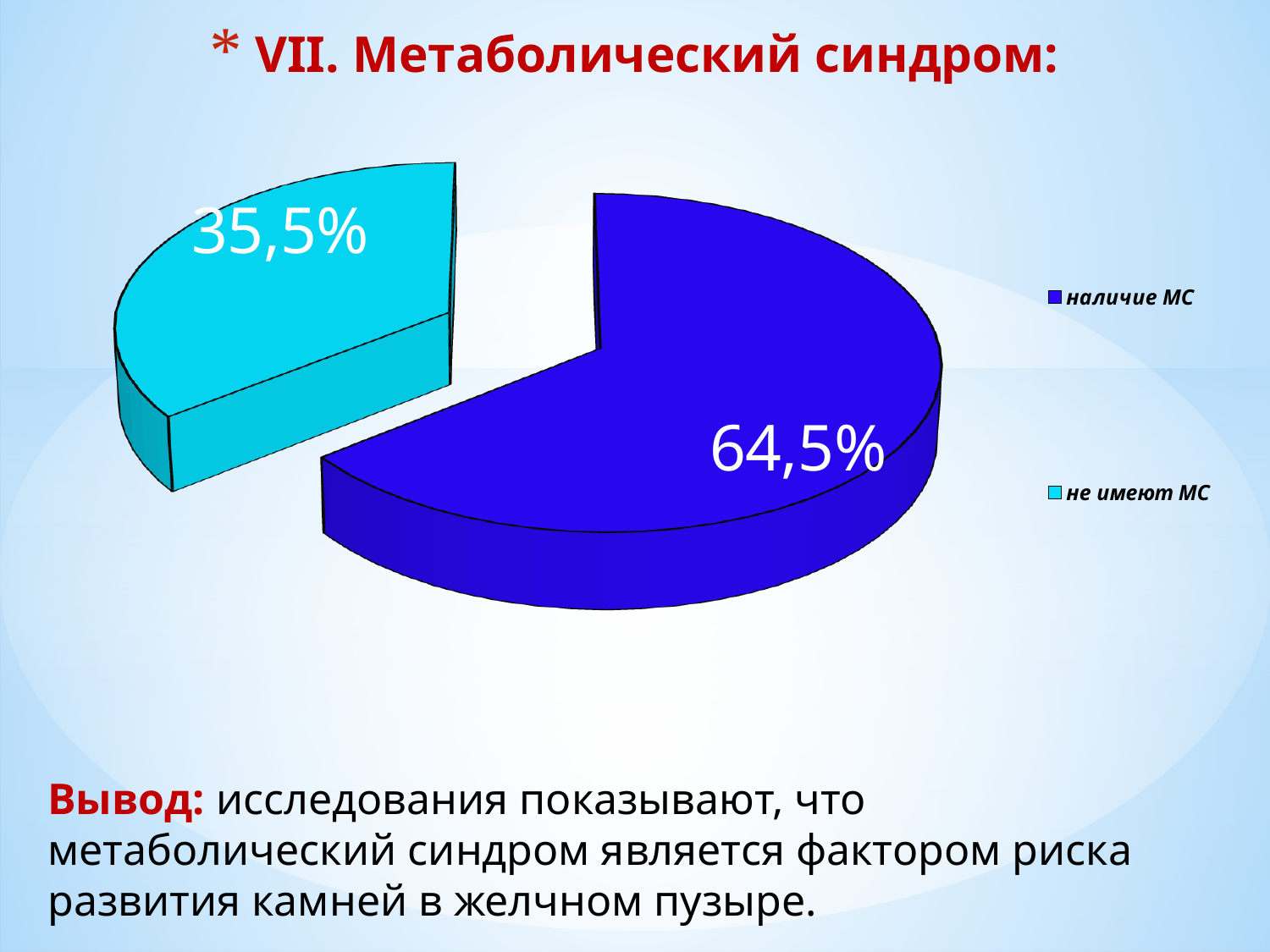
Which slice of the pie is the smallest? не имеют МС Which is larger: the share for "наличие МС" or for "не имеют МС"? наличие МС What share of the pie is labelled "не имеют МС"? 35,5% Which slice of the pie is the largest? наличие МС What colour is the "не имеют МС" slice? light blue (cyan) What share of the pie is labelled "наличие МС"? 64,5% How many slices does the pie chart have? 2 What is the difference in percentage points between the "наличие МС" and "не имеют МС" slices? 29 percentage points What is the title of the slide containing the chart? VII. Метаболический синдром: How many entries does the legend list? 2 What kind of chart is shown on the slide? pie chart